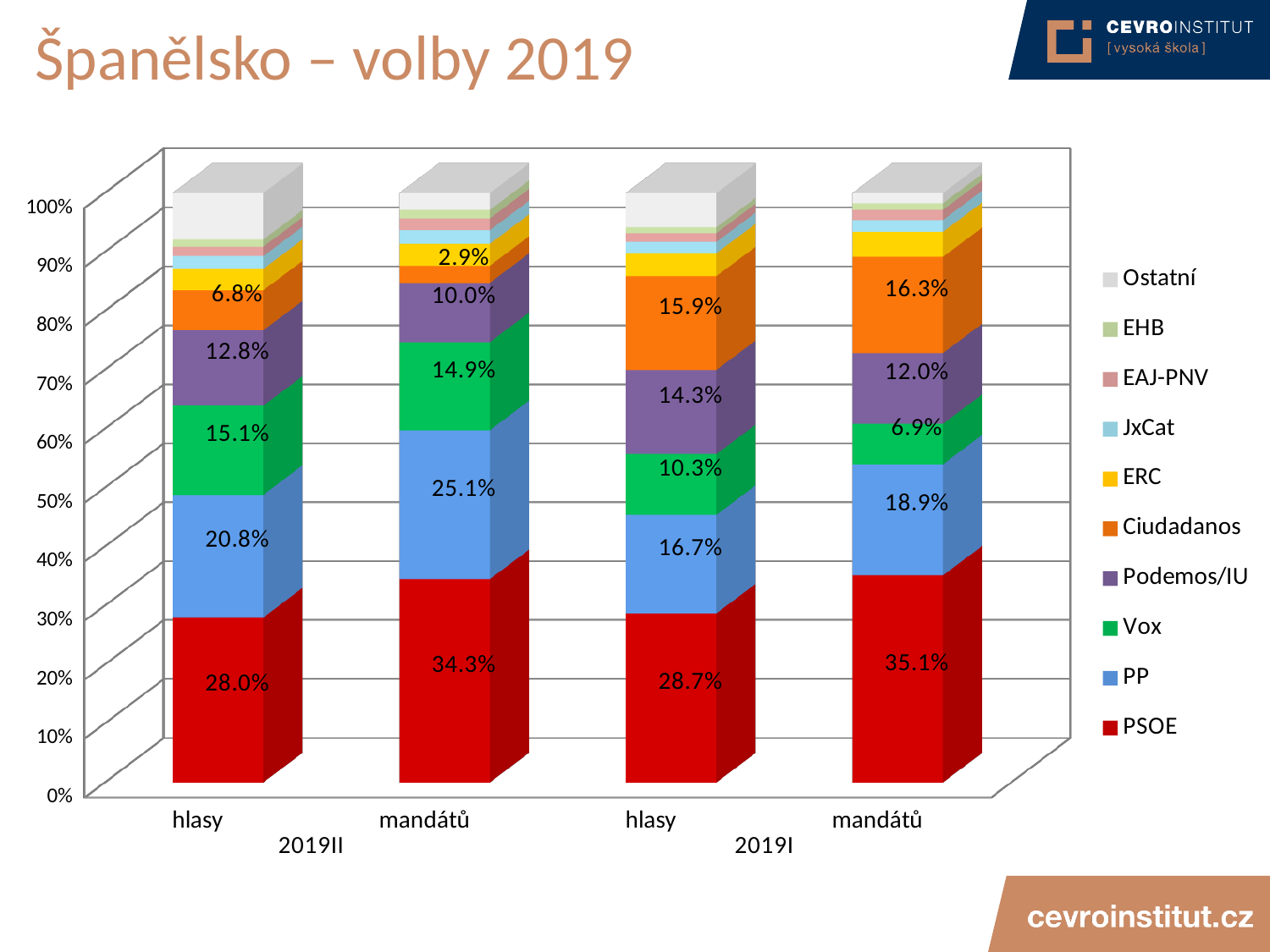
What share does PSOE have in the 'hlasy' bar for 2019II? 28.0% How many bars are plotted on the chart? 4 What share does PP have in the 'mandátů' bar for 2019II? 25.1% How much larger is PSOE's share in 'mandátů' 2019II than in 'hlasy' 2019II? 6.3 percentage points Is Vox's share larger in 'hlasy' 2019II or in 'hlasy' 2019I? hlasy 2019II What kind of chart is shown on the slide? Stacked bar chart In which bar does PSOE have its highest share? mandátů 2019I (35.1%) What share does Podemos/IU have in the 'hlasy' bar for 2019I? 14.3% In which bar does Vox have its lowest share? mandátů 2019I (6.9%) How many series does the legend list? 10 What share does Ciudadanos have in the 'hlasy' bar for 2019I? 15.9% What share does Vox have in the 'mandátů' bar for 2019I? 6.9%